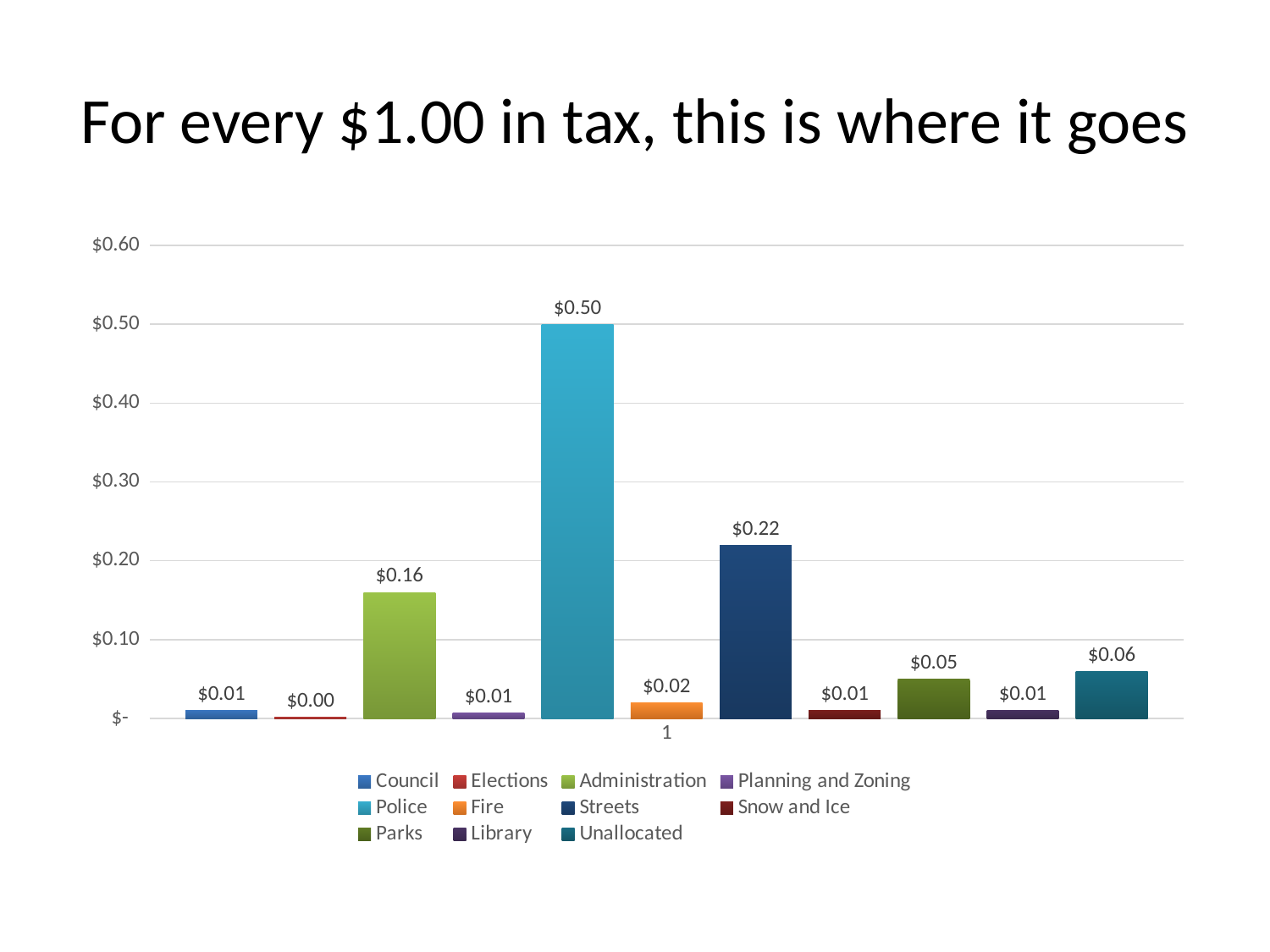
Is the value for Administration greater or less than $0.20? less How many series does the legend list? 11 What is the title of the slide? For every $1.00 in tax, this is where it goes What value is shown for Police? $0.50 What is the difference between the Police value and the Streets value? $0.28 Which series has the highest value? Police What value is shown for Unallocated? $0.06 What kind of chart is shown on the slide? bar chart What value is shown for Administration? $0.16 Which is larger, the value for Parks or the value for Unallocated? Unallocated Which series has the lowest value? Elections What value is shown for Streets? $0.22